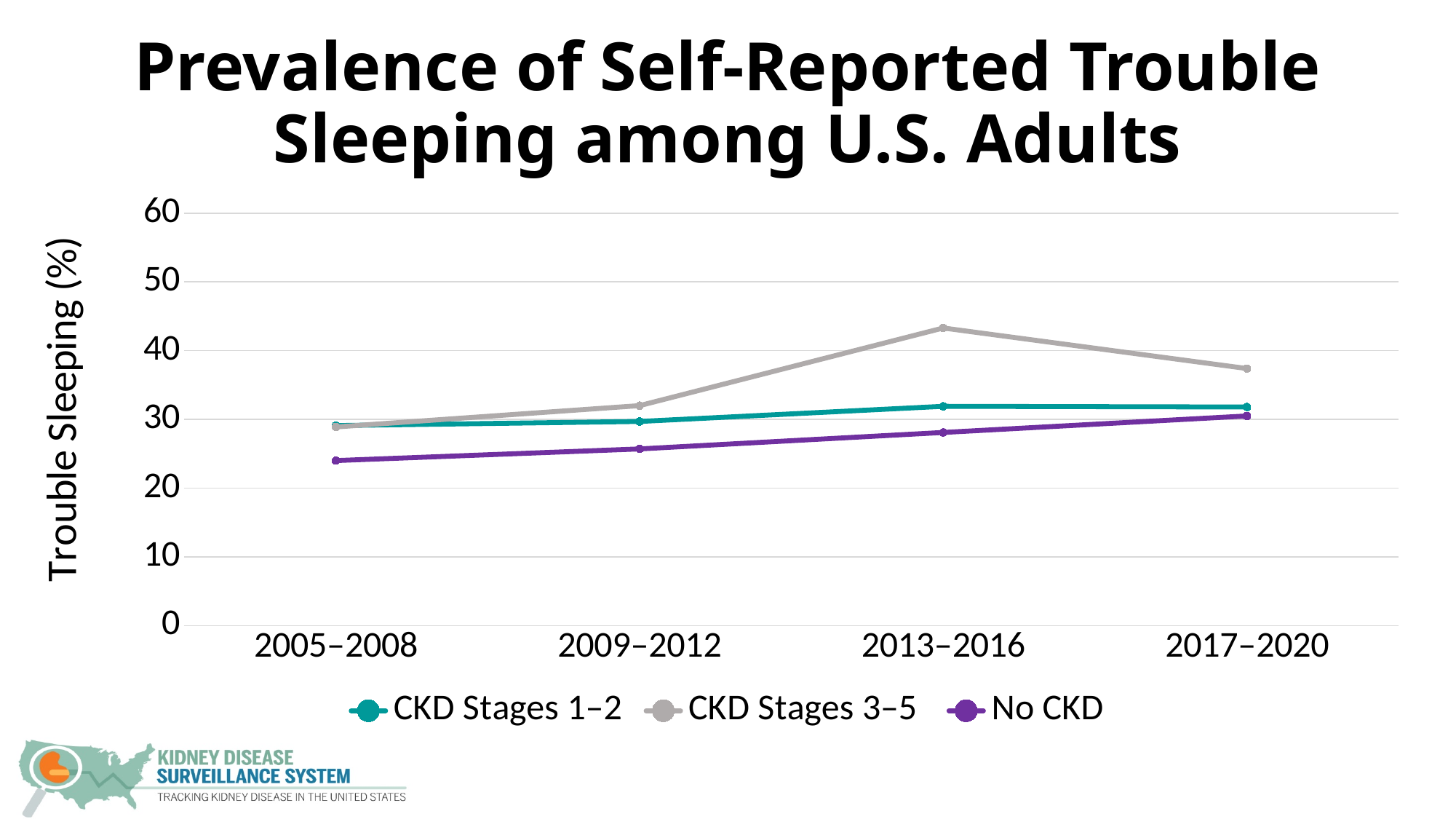
What kind of chart is shown on the slide? line chart How many time periods are shown on the x axis? 4 Which series has the highest value in 2013–2016? CKD Stages 3–5 Which is larger in 2013–2016, CKD Stages 3–5 or No CKD? CKD Stages 3–5 Is the value for No CKD in 2005–2008 greater or less than 30? less What is the label on the y axis? Trouble Sleeping (%) Does the No CKD line rise or fall from 2005–2008 to 2017–2020? rise Which series has the lowest value in 2005–2008? No CKD Is the value for CKD Stages 3–5 in 2013–2016 greater or less than 40? greater How many series does the legend list? 3 Is the value for CKD Stages 3–5 in 2017–2020 greater or less than 40? less In which period does CKD Stages 3–5 reach its highest value? 2013–2016